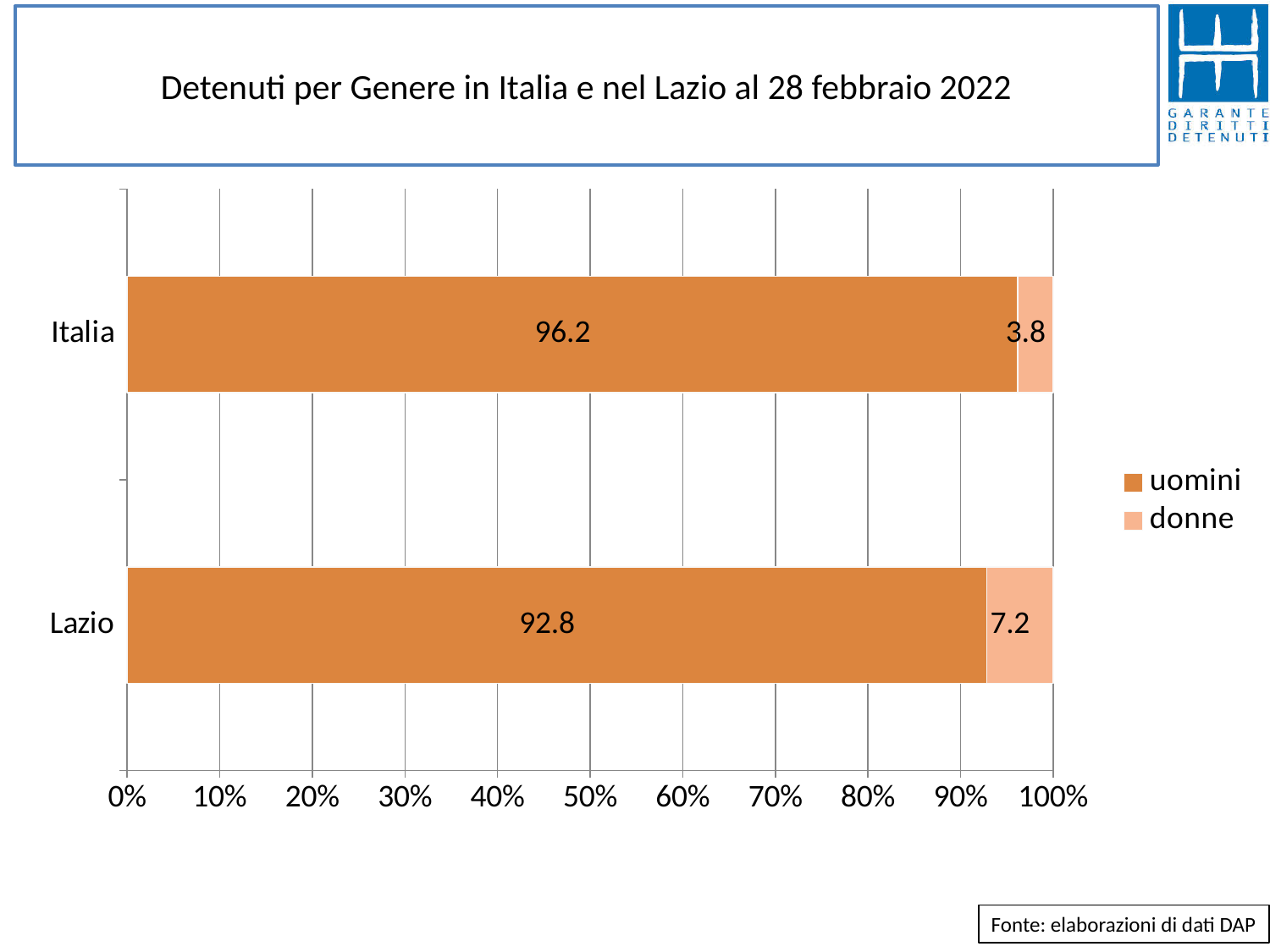
What is the value for donne in Lazio? 7.2 How many series does the legend list? 2 Which category has the lowest value for uomini? Lazio What is the difference between the donne values for Lazio and Italia? 3.4 What is the total of the stacked bar for Italia? 100 Which category has the higher value for donne, Italia or Lazio? Lazio What is the value for donne in Italia? 3.8 What is the value for uomini in Italia? 96.2 What kind of chart is shown on the slide? Stacked bar chart How many categories are shown on the chart? 2 What is the value for uomini in Lazio? 92.8 What is the difference between the uomini values for Italia and Lazio? 3.4